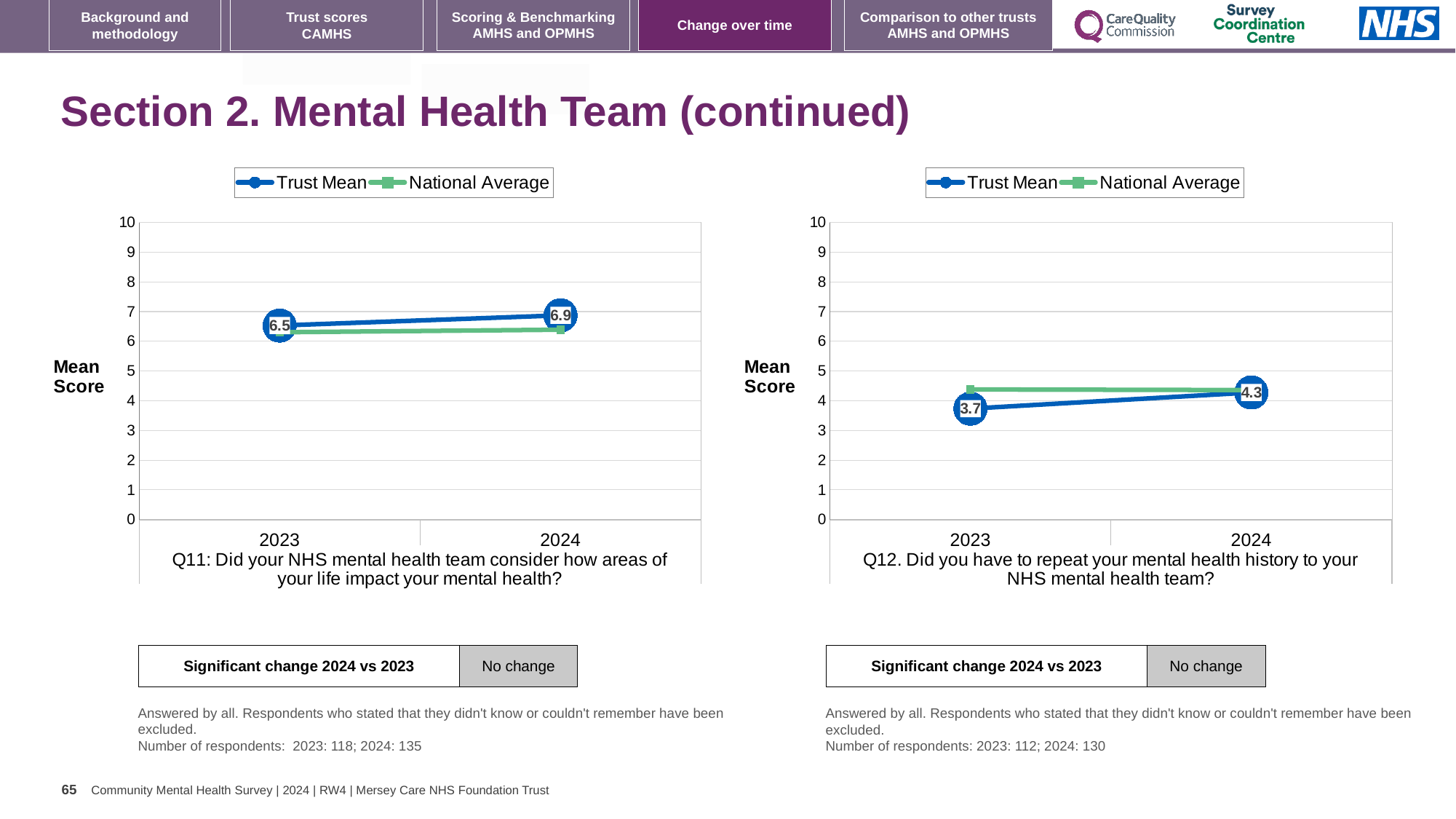
How many series does the legend of the Q12 chart (right) list? 2 In the Q12 chart (right), what is the Trust Mean score for 2024? 4.3 In the Q11 chart (left), what is the Trust Mean score for 2024? 6.9 In the Q11 chart (left), what is the Trust Mean score for 2023? 6.5 In the Q11 chart (left), by how much did the Trust Mean change from 2023 to 2024? 0.4 In the Q12 chart (right), what is the Trust Mean score for 2023? 3.7 In the Q12 chart (right), does the Trust Mean rise or fall from 2023 to 2024? rise In the Q12 chart (right), by how much did the Trust Mean change from 2023 to 2024? 0.6 What kind of chart is the Q11 chart on the left? line chart In the Q12 chart (right), is the National Average value for 2023 greater or less than 4? greater How many years are shown on the x axis of the Q11 chart (left)? 2 In the Q11 chart (left), which series has the higher value in 2024, Trust Mean or National Average? Trust Mean